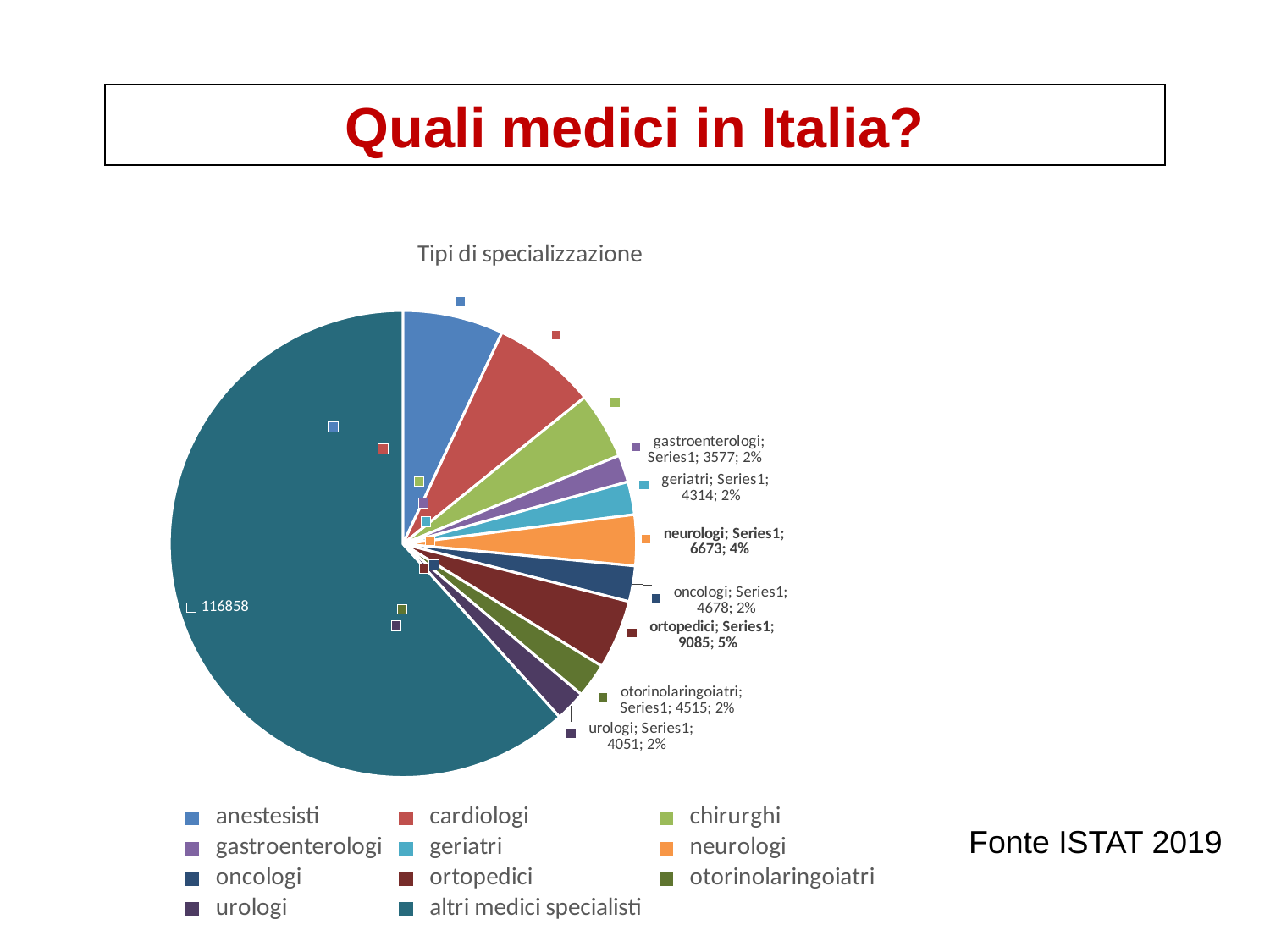
What share of the pie does neurologi represent? 4% What share of the pie does ortopedici represent? 5% What is the title of the pie chart? Tipi di specializzazione What is the difference between the values for ortopedici and neurologi? 2412 What kind of chart is shown on the slide? pie chart What is the value shown for neurologi? 6673 Which is larger, the value for ortopedici or the value for neurologi? ortopedici How many categories does the legend of the pie chart list? 11 What is the value shown for altri medici specialisti? 116858 Which category has the largest slice of the pie? altri medici specialisti What is the value shown for gastroenterologi? 3577 What is the value shown for ortopedici? 9085